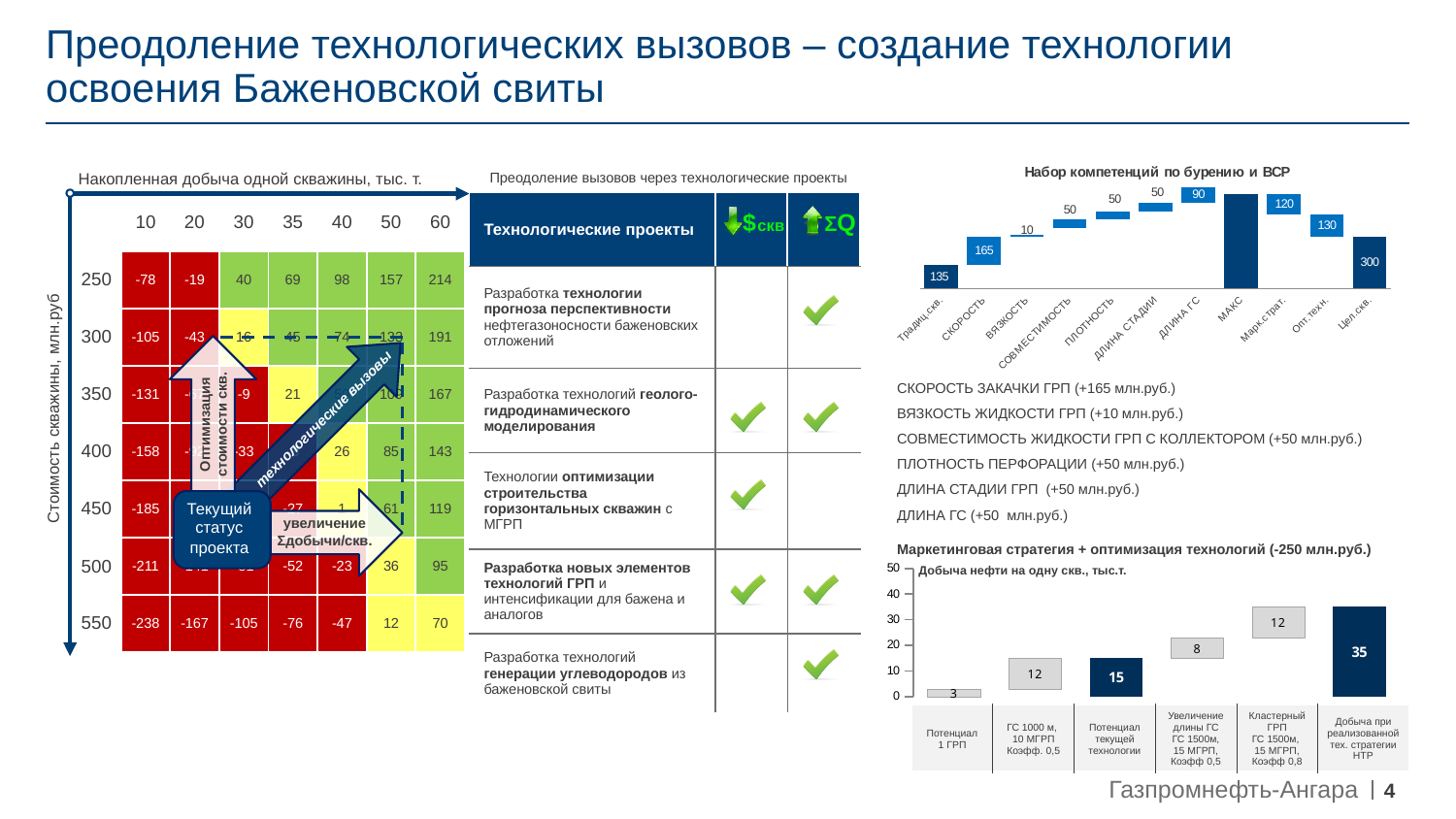
In the chart 'Набор компетенций по бурению и ВСР', what is the value for 'Традиц.скв.'? 135 In the chart 'Добыча нефти на одну скв., тыс.т.', what is the difference between the value for 'Добыча при реализованной тех. стратегии НТР' and the value for 'Потенциал текущей технологии'? 20 In the chart 'Добыча нефти на одну скв., тыс.т.', what is the value for 'Добыча при реализованной тех. стратегии НТР'? 35 What kind of chart is 'Добыча нефти на одну скв., тыс.т.'? bar chart In the chart 'Набор компетенций по бурению и ВСР', what is the value for 'Цел.скв.'? 300 In the chart 'Добыча нефти на одну скв., тыс.т.', what is the value for 'Потенциал 1 ГРП'? 3 In the chart 'Добыча нефти на одну скв., тыс.т.', how many bars are plotted? 6 In the chart 'Набор компетенций по бурению и ВСР', which is larger: the value for 'Скорость' or the value for 'Вязкость'? Скорость In the chart 'Добыча нефти на одну скв., тыс.т.', what is the value for 'Потенциал текущей технологии'? 15 In the chart 'Добыча нефти на одну скв., тыс.т.', is the value for 'Добыча при реализованной тех. стратегии НТР' greater or less than 30? greater In the chart 'Добыча нефти на одну скв., тыс.т.', which category has the lowest value? Потенциал 1 ГРП In the chart 'Добыча нефти на одну скв., тыс.т.', which category has the highest value? Добыча при реализованной тех. стратегии НТР